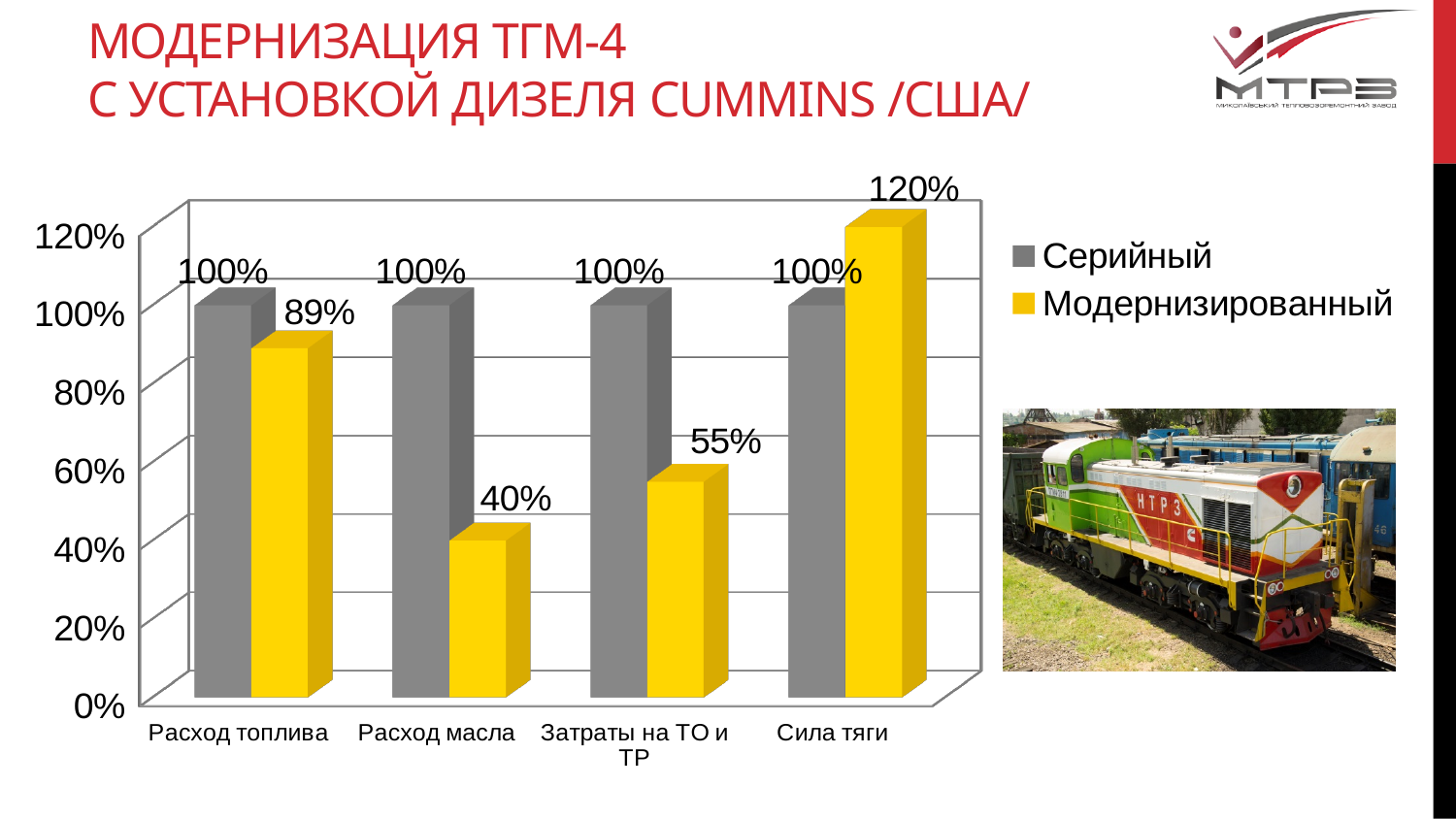
How many series does the chart legend list? 2 What kind of chart is shown on the slide? Bar chart In which category does the Модернизированный series have its highest value? Сила тяги What is the value for Серийный in the Сила тяги category? 100% What is the value for Модернизированный in the Затраты на ТО и ТР category? 55% What is the value for Модернизированный in the Расход масла category? 40% What is the difference between the Серийный and Модернизированный values in the Расход масла category? 60% Which series is shown in yellow in the chart? Модернизированный In which category does the Модернизированный series have its lowest value? Расход масла How many categories are shown on the x axis of the chart? 4 Which is larger in the Сила тяги category: the Серийный value or the Модернизированный value? Модернизированный What is the value for Модернизированный in the Расход топлива category? 89%